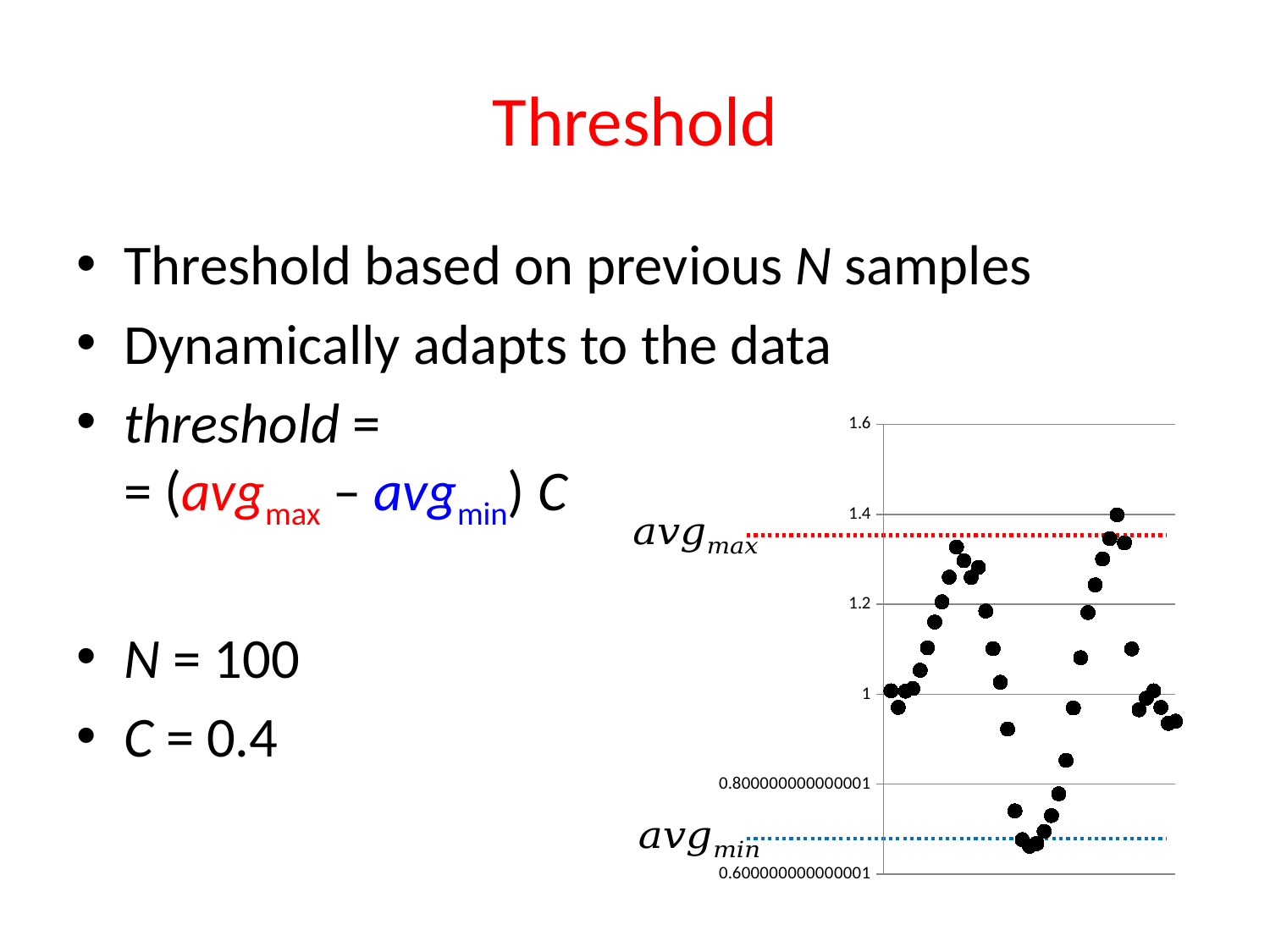
Is the lowest plotted point on the chart greater or less than 0.6? greater Is the red dotted avg max line above or below the 1.2 gridline? above What is the highest value shown on the chart's vertical axis? 1.6 What kind of chart is shown on the slide? scatter chart Is the highest plotted point on the chart greater or less than 1.6? less What does the blue dotted horizontal line on the chart represent? avg min What does the red dotted horizontal line on the chart represent? avg max